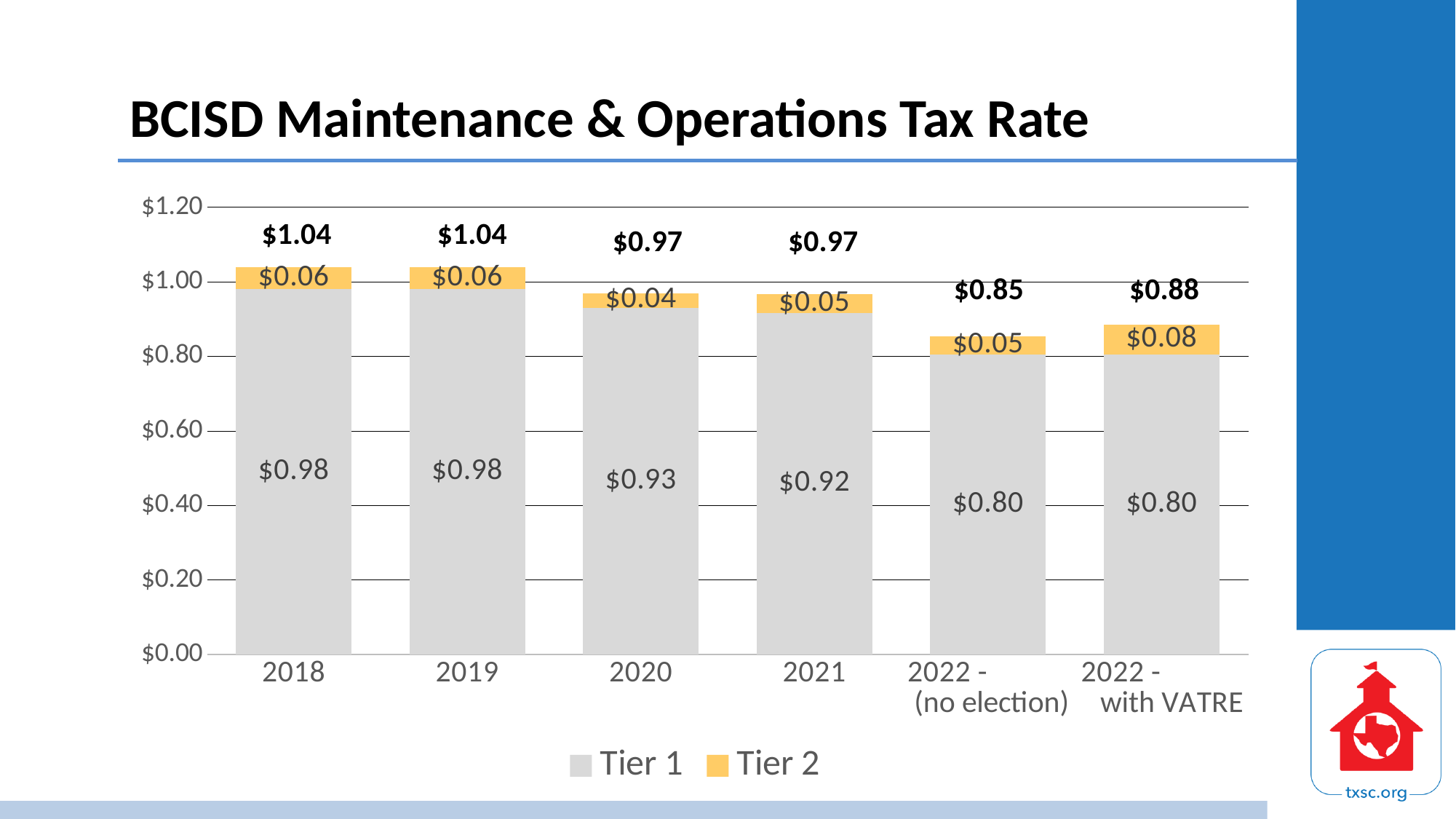
Which category has the highest Tier 2 value? 2022 - with VATRE What kind of chart is shown on the slide? Stacked bar chart Is the Tier 1 value larger in 2021 or in 2022 - (no election)? 2021 What is the title of the chart? BCISD Maintenance & Operations Tax Rate What is the Tier 1 value for 2020? $0.93 What is the difference between the total tax rate in 2018 and in 2022 - with VATRE? $0.16 How many series does the legend list? 2 Which category has the lowest total tax rate? 2022 - (no election) How many categories are shown on the x axis? 6 What is the Tier 2 value for 2022 - with VATRE? $0.08 What is the total tax rate shown for 2022 - (no election)? $0.85 Do the total tax rates generally rise or fall from 2018 to 2022 - (no election)? Fall